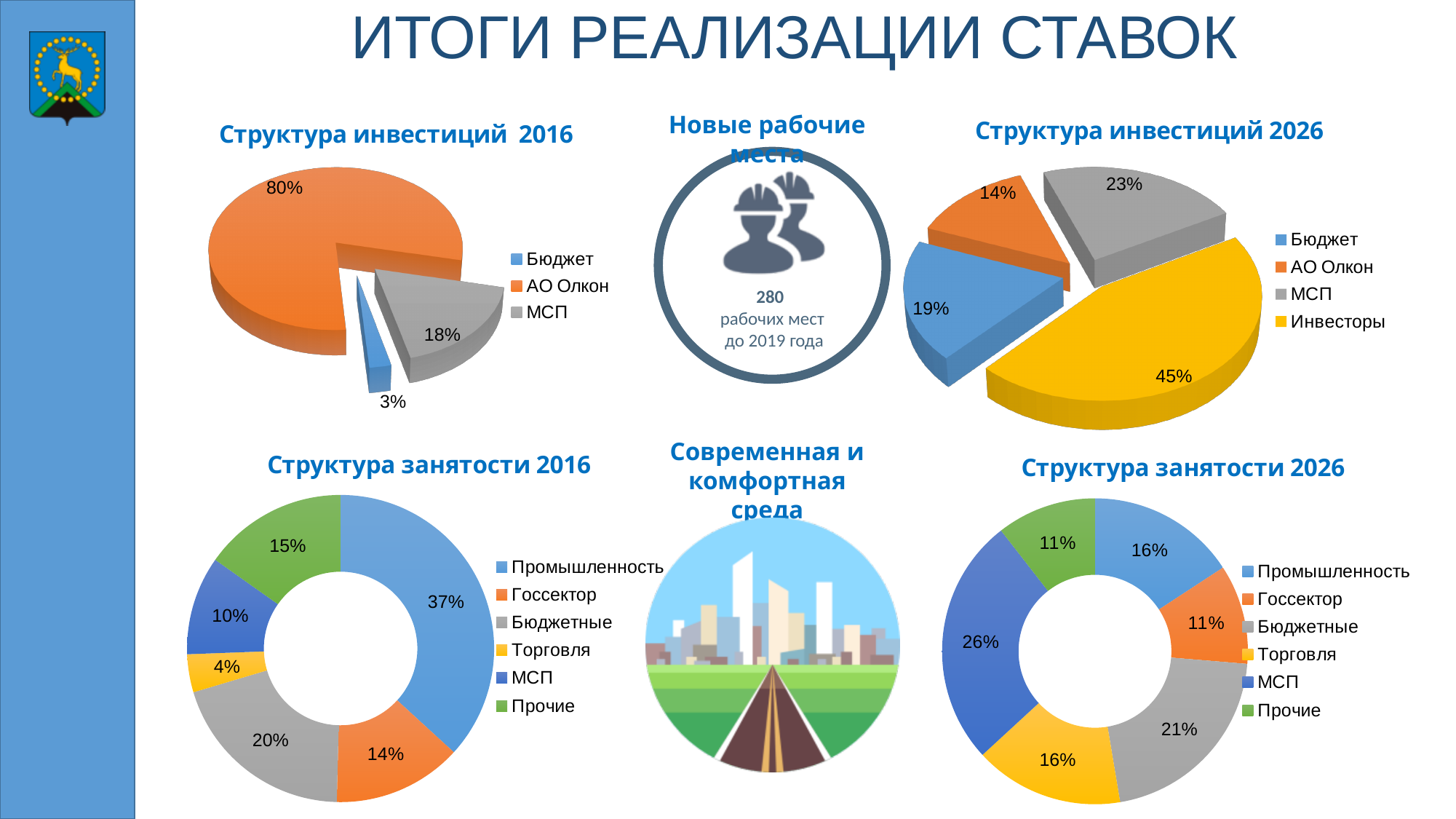
In the chart 'Структура занятости 2026', what is the difference between the shares of МСП and Промышленность? 10% In the chart 'Структура занятости 2016', which is larger: Бюджетные or Прочие? Бюджетные In the chart 'Структура занятости 2016', what share does Промышленность have? 37% In the chart 'Структура инвестиций 2016', which category has the smallest share? Бюджет In the chart 'Структура инвестиций 2016', what share does АО Олкон have? 80% In the chart 'Структура инвестиций 2026', what is the difference between the shares of МСП and АО Олкон? 9% In the chart 'Структура занятости 2026', what share does МСП have? 26% In the chart 'Структура инвестиций 2026', what share do Инвесторы have? 45% In the chart 'Структура занятости 2016', which category has the smallest share? Торговля How many categories does the legend of the chart 'Структура инвестиций 2026' list? 4 What kind of chart is 'Структура занятости 2026'? Doughnut chart In the chart 'Структура инвестиций 2026', which category has the largest share? Инвесторы